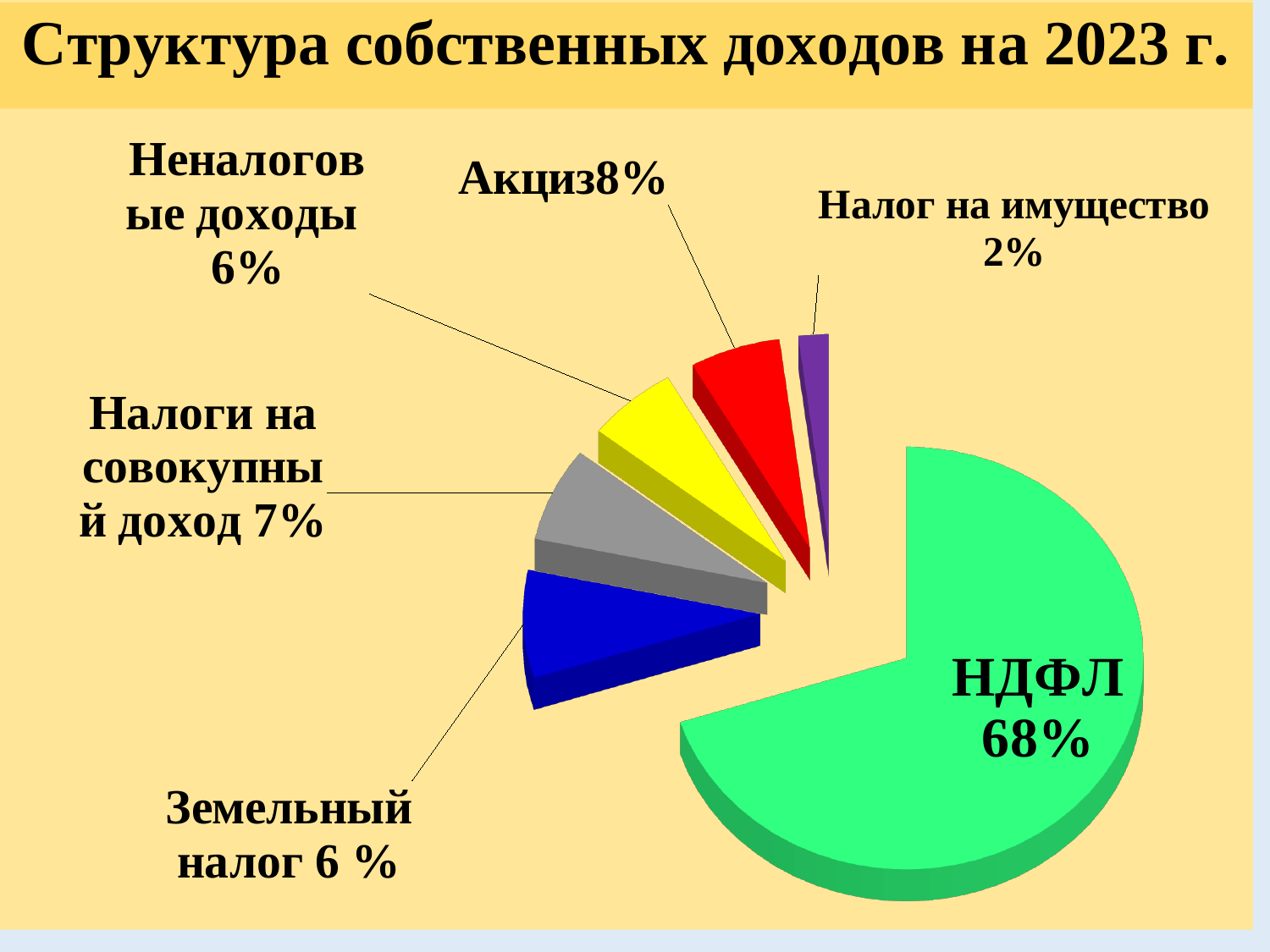
What is the value shown for Акциз? 8% Which category has the smallest slice of the pie? Налог на имущество What is the value shown for Налоги на совокупный доход? 7% What is the title of the chart? Структура собственных доходов на 2023 г. What kind of chart is shown on the slide? Pie chart Which category has the largest slice of the pie? НДФЛ What share of the pie does НДФЛ have? 68% How many slices does the pie chart have? 6 What is the value shown for Налог на имущество? 2% What is the difference between the shares of НДФЛ and Акциз? 60% Which is larger, the share of Акциз or the share of Налоги на совокупный доход? Акциз What is the value shown for Неналоговые доходы? 6%